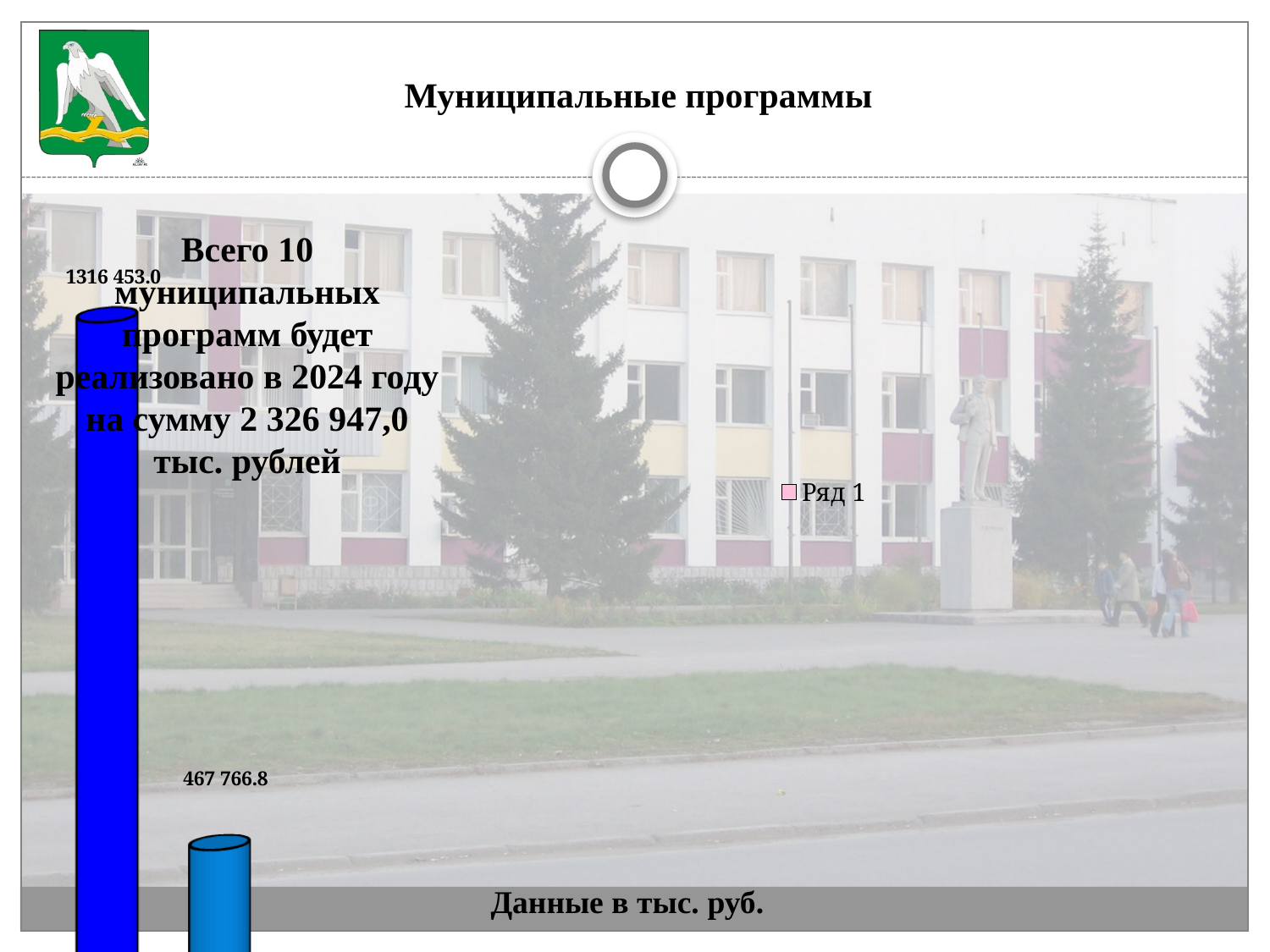
What is the name of the series shown in the chart legend? Ряд 1 What value is printed above the second bar from the left in the chart? 467 766.8 What value is printed above the tallest bar in the chart? 1316 453.0 Which is larger, the value of the leftmost bar (1316 453.0) or the value of the second bar (467 766.8)? 1316 453.0 Which bar is the tallest in the chart, the leftmost one or the second from the left? the leftmost one What kind of chart is shown on the slide? bar chart In what units are the chart's data given, according to the note at the bottom of the slide? тыс. руб. What is the difference between the leftmost bar's value (1316 453.0) and the second bar's value (467 766.8)? 848 686.2 How many series does the chart legend list? 1